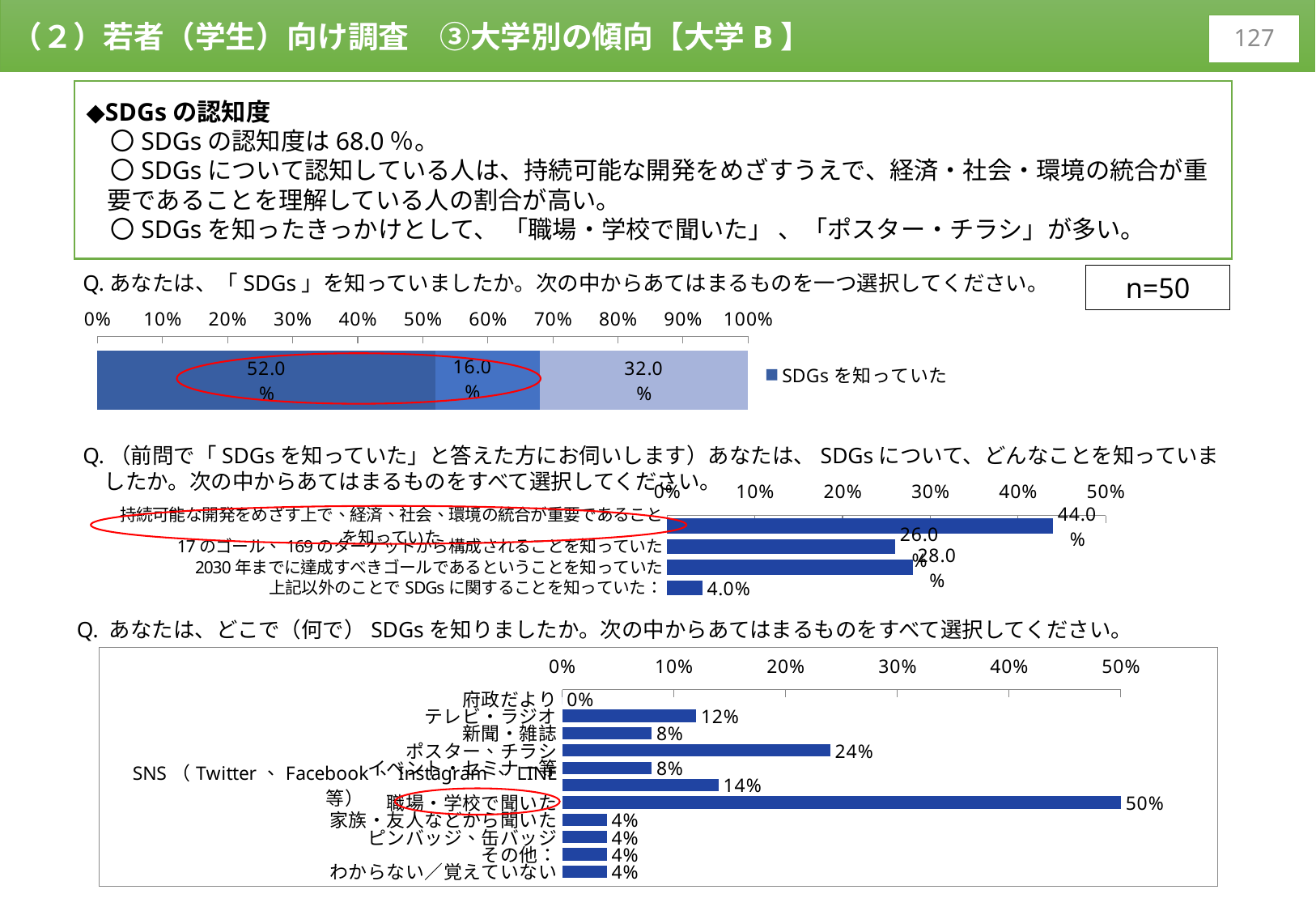
In the bottom chart (where did you learn about SDGs), which category has the highest value? 職場・学校で聞いた In the top stacked bar chart (did you know SDGs), what is the total of the first two segments (52.0% and 16.0%)? 68.0% What type of chart is the bottom chart (where did you learn about SDGs)? bar chart In the bottom chart (where did you learn about SDGs), which category has the lowest value? 府政だより In the bottom chart (where did you learn about SDGs), what is the value for 職場・学校で聞いた? 50% In the middle chart (what did you know about SDGs), what is the highest value shown? 44.0% In the bottom chart (where did you learn about SDGs), how many categories are plotted? 11 In the bottom chart (where did you learn about SDGs), what is the difference between テレビ・ラジオ and 新聞・雑誌? 4% In the bottom chart (where did you learn about SDGs), what is the value for ポスター・チラシ? 24% In the top stacked bar chart (did you know SDGs), what is the value of the first (leftmost) segment? 52.0% In the middle chart (what did you know about SDGs), which is larger: 17のゴール、169のターゲットから構成されることを知っていた or 2030年までに達成すべきゴールであるということを知っていた? 2030年までに達成すべきゴールであるということを知っていた In the middle chart (what did you know about SDGs), what is the value for 上記以外のことでSDGsに関することを知っていた? 4.0%